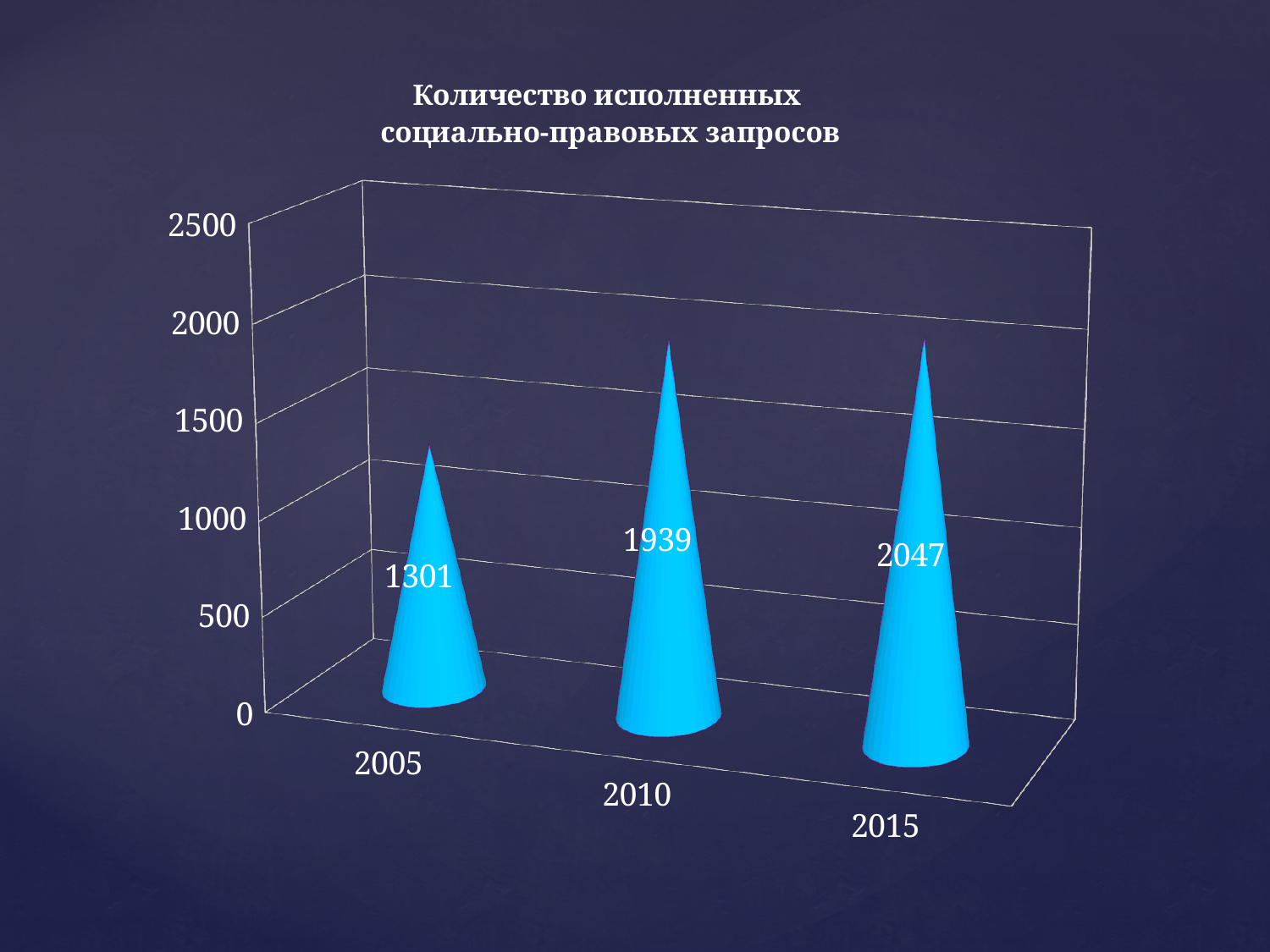
Is the value for 2005 greater or less than 1500? less What is the value for 2010? 1939 What is the difference between the values for 2010 and 2005? 638 Which year has the lowest value? 2005 How many years are shown on the chart? 3 What is the value for 2015? 2047 Do the values rise or fall from 2005 to 2015? rise What is the value for 2005? 1301 Which year has the highest value? 2015 What is the difference between the values for 2015 and 2005? 746 Which is larger, the value for 2010 or the value for 2005? 2010 What kind of chart is this? bar chart